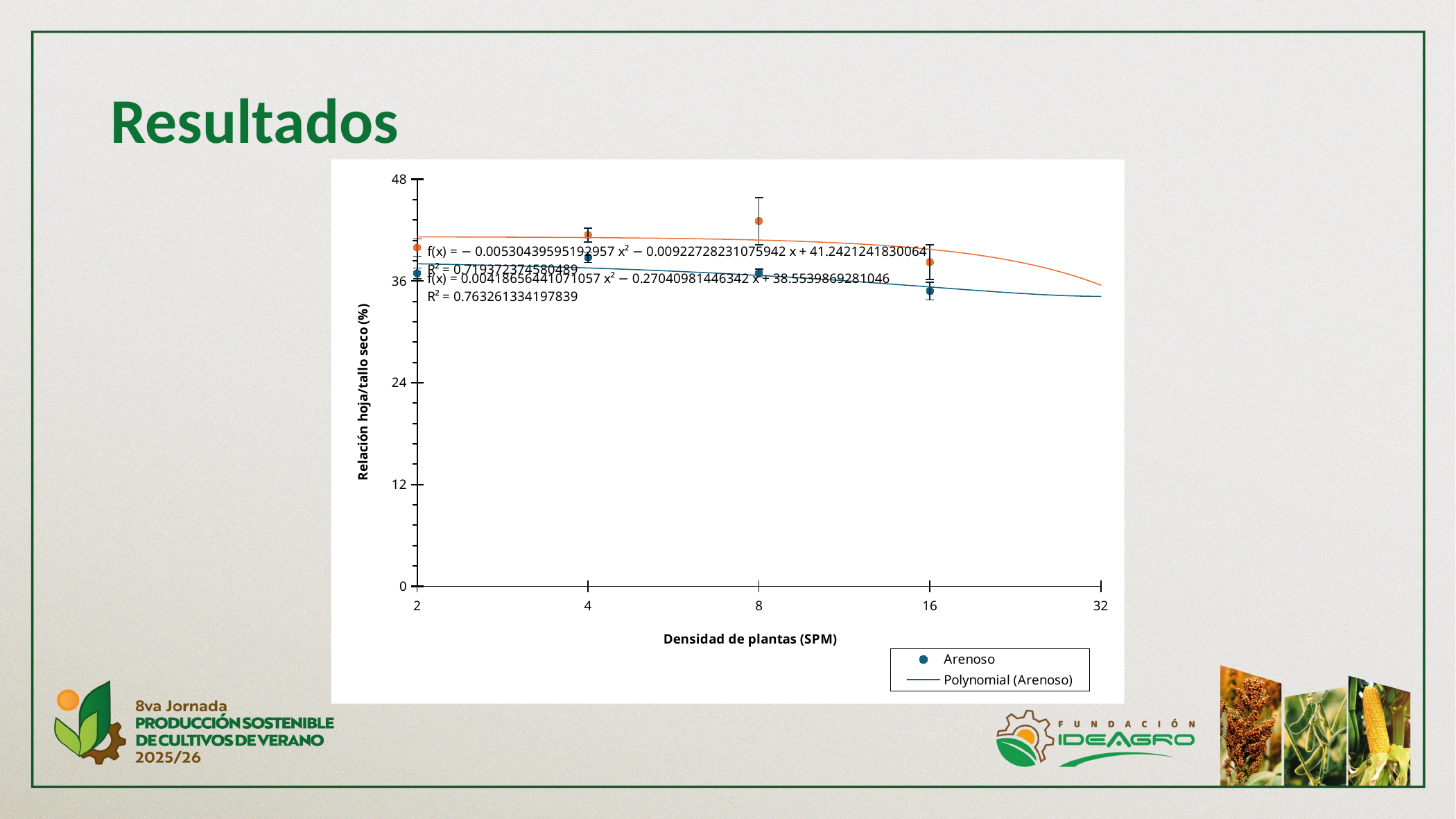
What R² value is shown for the polynomial fit with intercept 38.5539869281046? 0.763261334197839 Is the Arenoso value at a plant density of 16 greater or less than 36? less Is the Arenoso value at a plant density of 4 greater or less than 36? greater What is the title of the x axis of the chart? Densidad de plantas (SPM) Is the orange point at a plant density of 8 greater or less than 48? less How many entries does the chart legend list? 2 Do the Arenoso values rise or fall overall as plant density increases from 2 to 16? Fall At a plant density of 8, which is larger: the orange point or the Arenoso (blue) point? The orange point What is the title of the y axis of the chart? Relación hoja/tallo seco (%) What kind of chart is shown on the slide? Scatter chart